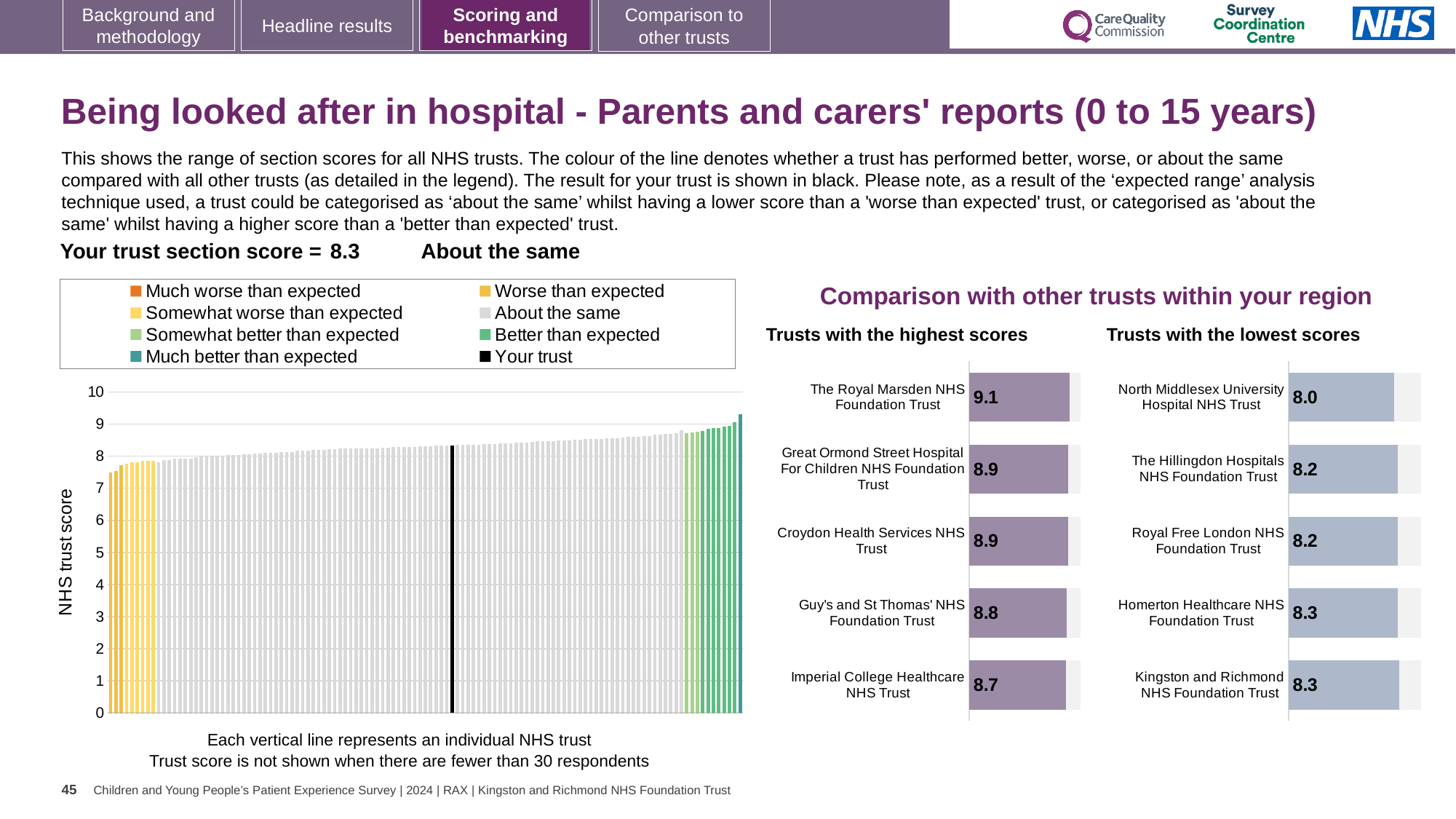
In the NHS trust score chart on the left, do the values rise or fall from left to right? rise How many trusts are listed in the 'Trusts with the highest scores' chart? 5 In the 'Trusts with the lowest scores' chart, which trust has the lowest score? North Middlesex University Hospital NHS Trust What kind of chart is the NHS trust score chart on the left of the slide? bar chart How many entries does the legend of the NHS trust score chart on the left list? 8 In the 'Trusts with the lowest scores' chart, what is the score for North Middlesex University Hospital NHS Trust? 8.0 In the 'Trusts with the highest scores' chart, which has the larger score: Guy's and St Thomas' NHS Foundation Trust or Imperial College Healthcare NHS Trust? Guy's and St Thomas' NHS Foundation Trust In the 'Trusts with the highest scores' chart, what is the difference between the scores of The Royal Marsden NHS Foundation Trust and Imperial College Healthcare NHS Trust? 0.4 In the NHS trust score chart on the left, what colour is used for 'Your trust' according to the legend? black In the 'Trusts with the lowest scores' chart, what is the difference between the scores of Homerton Healthcare NHS Foundation Trust and North Middlesex University Hospital NHS Trust? 0.3 In the 'Trusts with the highest scores' chart, what is the score for The Royal Marsden NHS Foundation Trust? 9.1 In the 'Trusts with the highest scores' chart, which trust has the highest score? The Royal Marsden NHS Foundation Trust